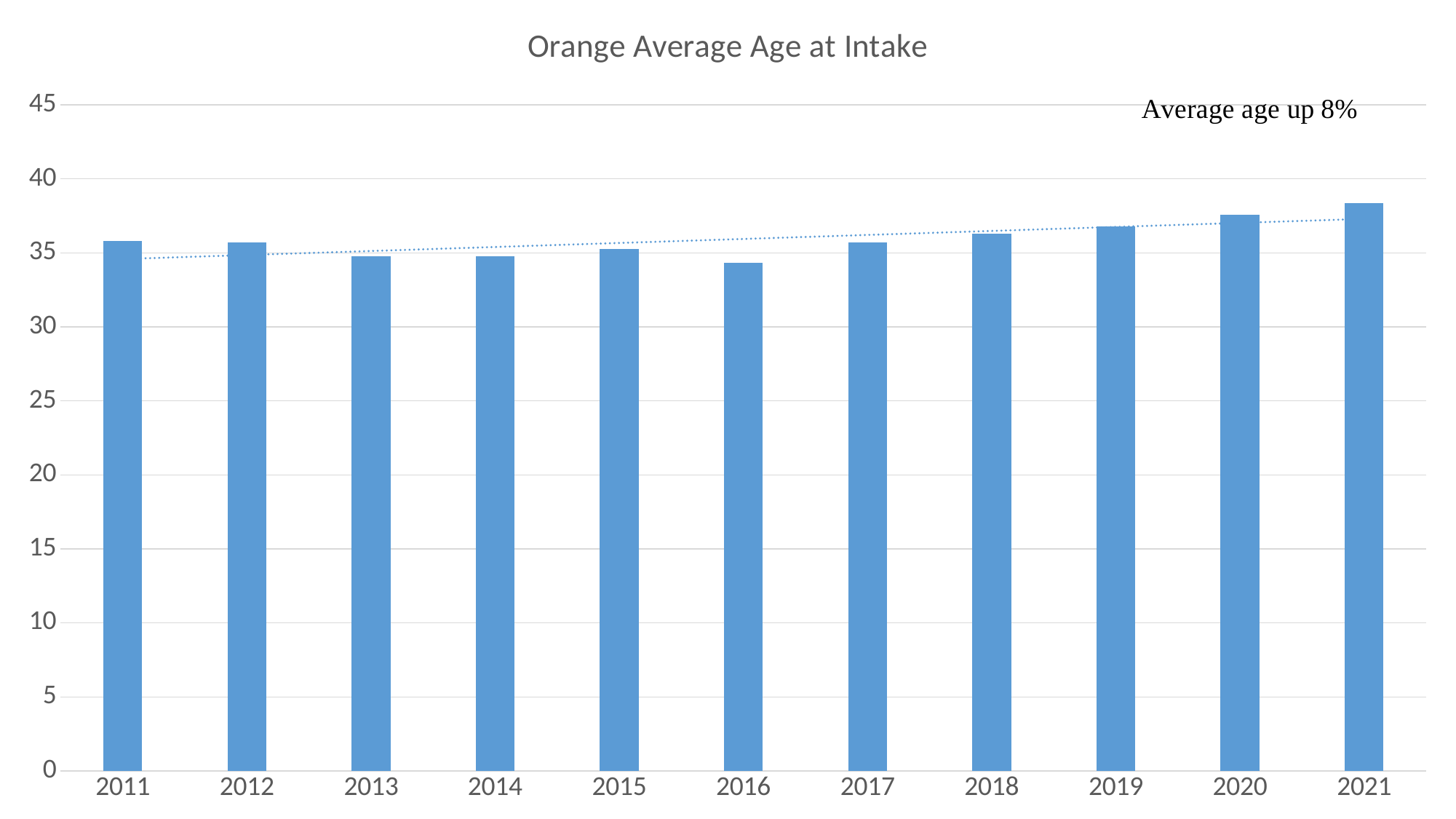
Which year has the highest average age at intake? 2021 What is the title of the chart? Orange Average Age at Intake Does the average age at intake generally rise or fall from 2016 to 2021? Rise Which year has the lowest average age at intake? 2016 Is the value for 2016 greater or less than 35? less Which year has a higher average age at intake, 2020 or 2013? 2020 What does the text annotation in the upper right of the chart say? Average age up 8% Is the value for 2019 greater or less than 35? greater What kind of chart is shown on the slide? Bar chart How many years are plotted on the x axis of the chart? 11 Is the value for 2021 greater or less than 35? greater